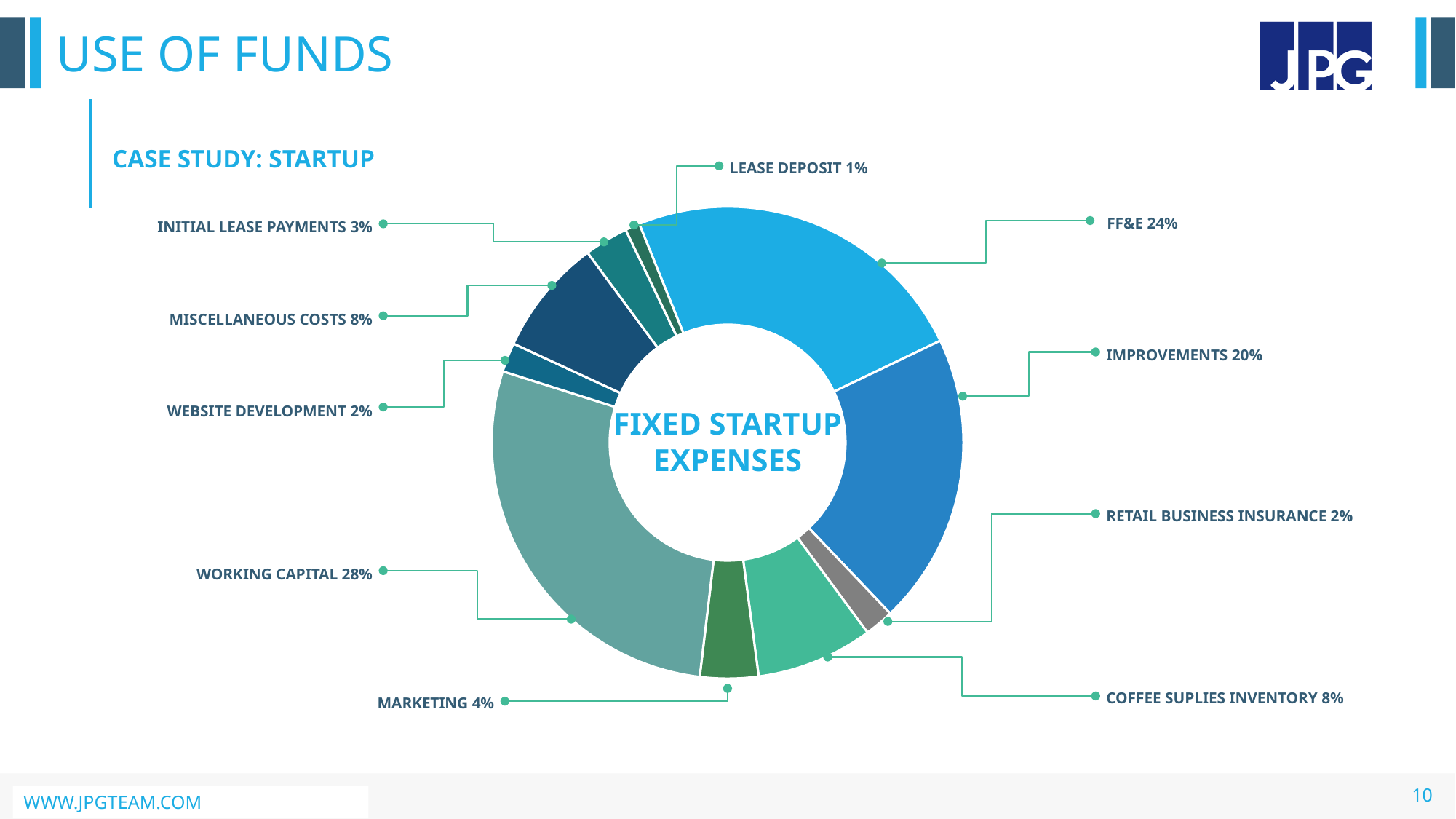
Which category has the largest share of fixed startup expenses? Working Capital How many categories are shown in the chart? 10 What percentage is shown for FF&E? 24% What share is allocated to Coffee Supplies Inventory? 8% What text appears in the centre of the donut chart? FIXED STARTUP EXPENSES Which category has the smallest share of fixed startup expenses? Lease Deposit Which is larger, Improvements or Miscellaneous Costs? Improvements What percentage of fixed startup expenses is Working Capital? 28% What percentage is shown for Lease Deposit? 1% What is the combined share of Marketing and Initial Lease Payments? 7% What is the difference in percentage points between Working Capital and FF&E? 4 What kind of chart is shown on the slide? Pie chart (donut)